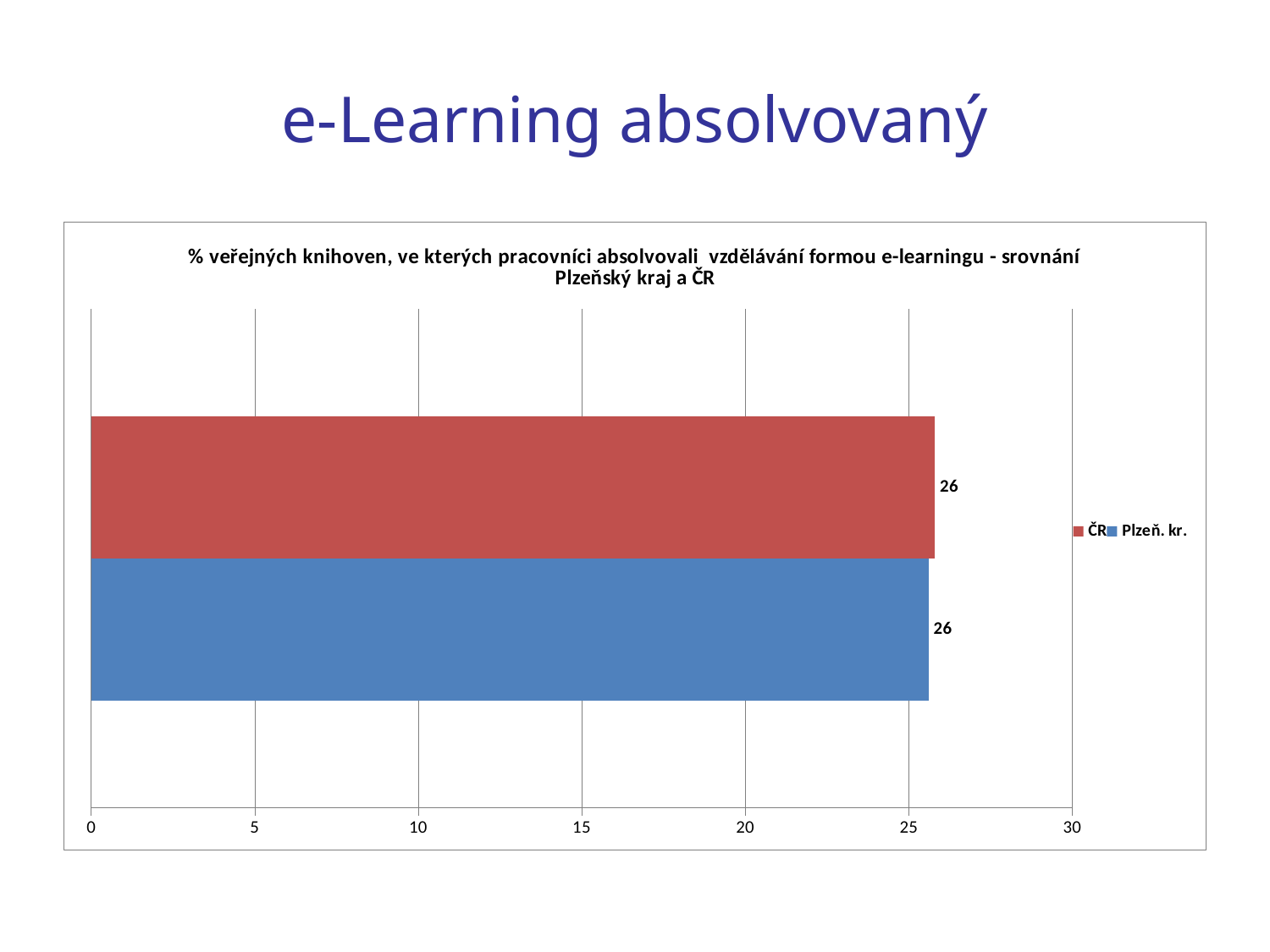
What is the value for ČR? 26 What is the highest value shown on the horizontal axis? 30 What kind of chart is shown on the slide? bar chart Is the value for ČR greater or less than 25? greater Is the value for Plzeň. kr. greater or less than 30? less What is the difference between the values for ČR and Plzeň. kr.? 0 How many bars are plotted in the chart? 2 What is the value for Plzeň. kr.? 26 How many series does the legend list? 2 Which series is shown in red? ČR